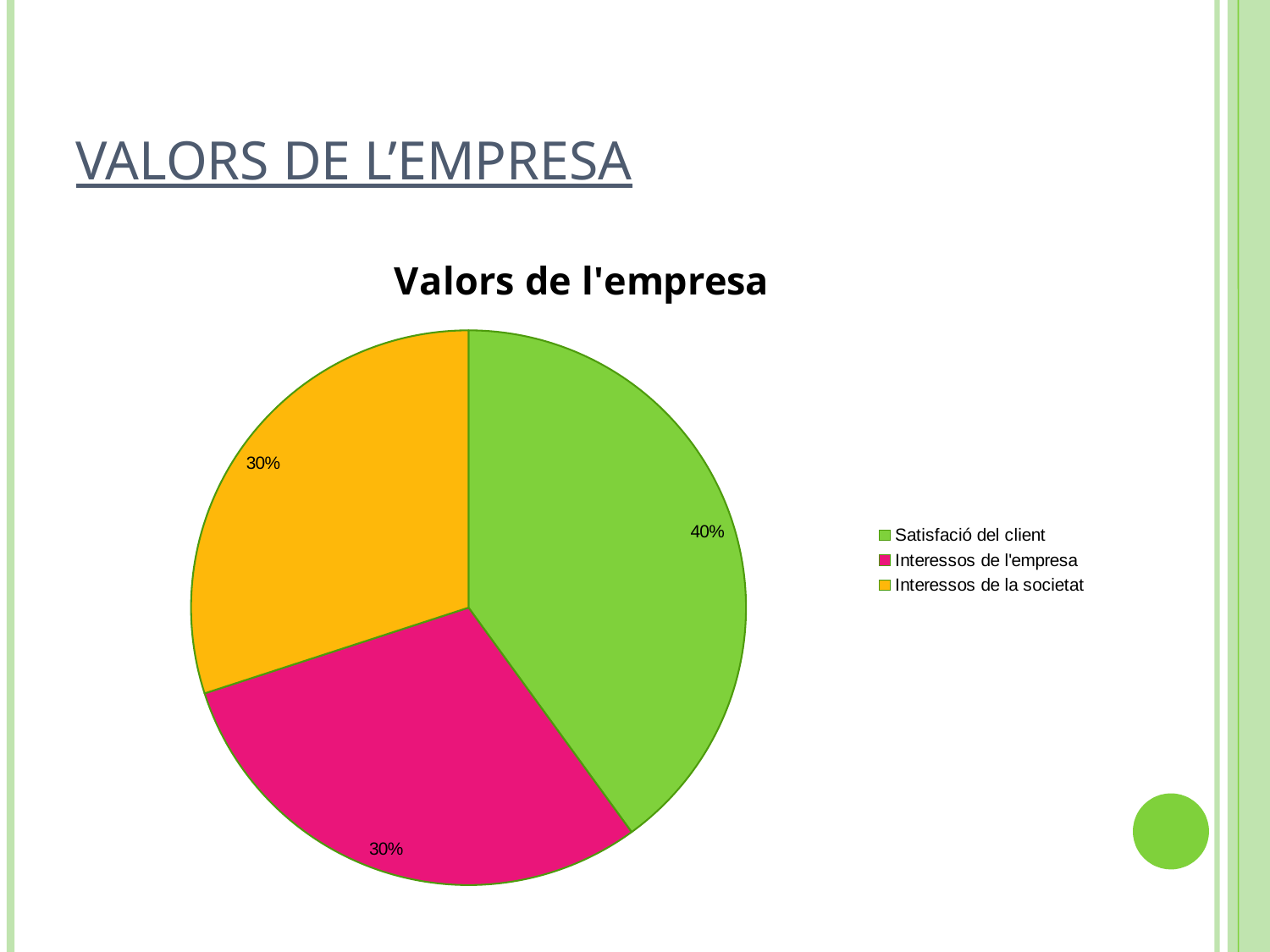
What share of the pie does Interessos de l'empresa have? 30% Which category has the largest slice of the pie? Satisfació del client How many entries does the legend list? 3 What share of the pie does Interessos de la societat have? 30% What share of the pie does Satisfació del client have? 40% What is the title of the chart? Valors de l'empresa What kind of chart is shown on the slide? pie chart What is the difference between the share for Satisfació del client and the share for Interessos de l'empresa? 10% Which is larger, the share for Satisfació del client or the share for Interessos de la societat? Satisfació del client What is the combined share of Interessos de l'empresa and Interessos de la societat? 60% What colour is the slice for Interessos de l'empresa? pink How many slices does the pie chart have? 3